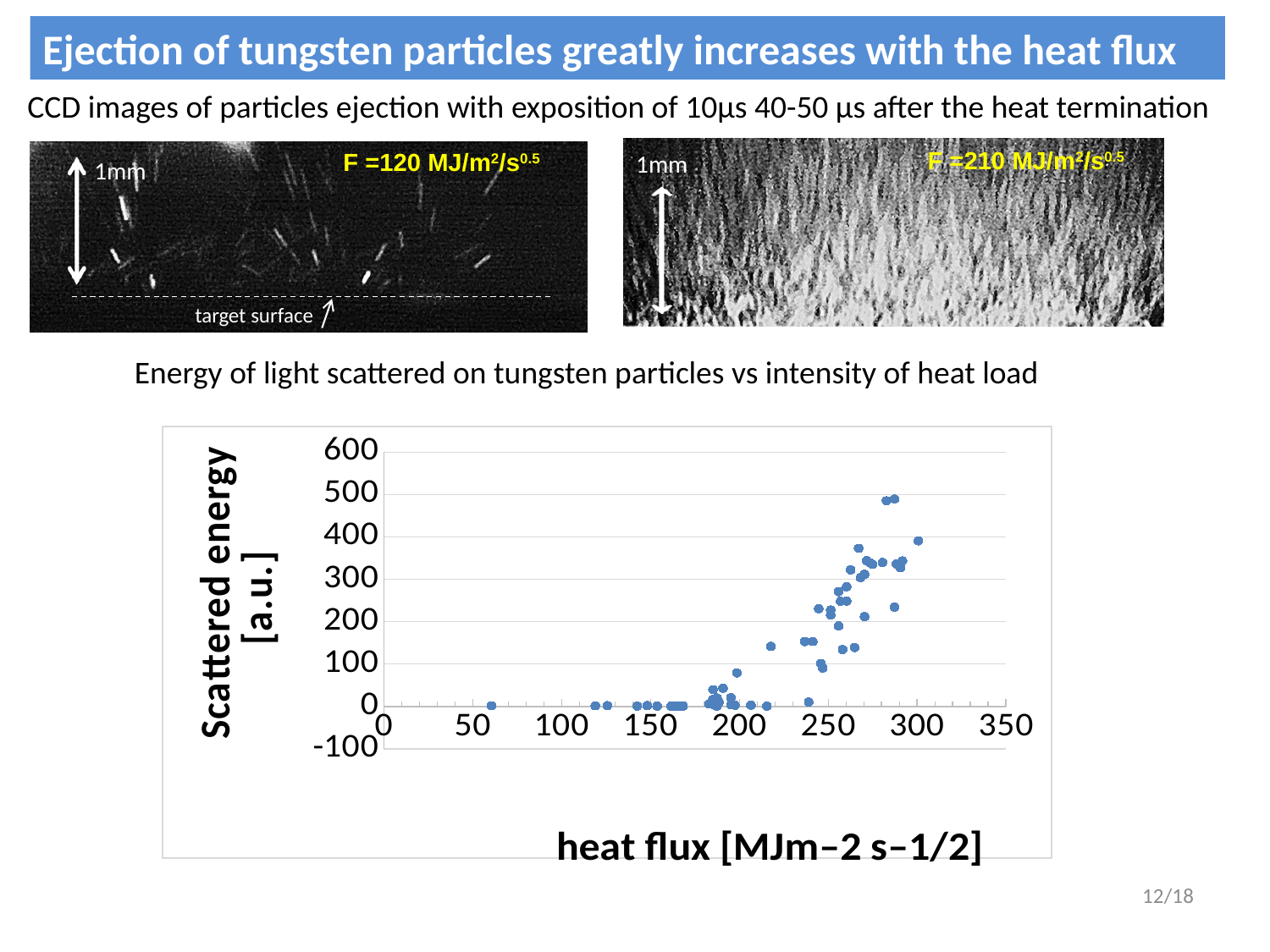
What is the label of the x axis of the chart? heat flux [MJm–2 s–1/2] Does the scattered energy generally rise or fall as the heat flux increases along the x axis? rise What is the lowest tick value shown on the y axis? -100 What is the highest tick value shown on the x axis? 350 What kind of chart is shown on the slide? scatter chart Are the scattered energy values for points with heat flux below 150 greater or less than 100? less Is the scattered energy of the point at a heat flux of about 300 greater or less than 300? greater Is the heat flux of the rightmost plotted point greater or less than 350? less What is the label of the y axis of the chart? Scattered energy [a.u.]